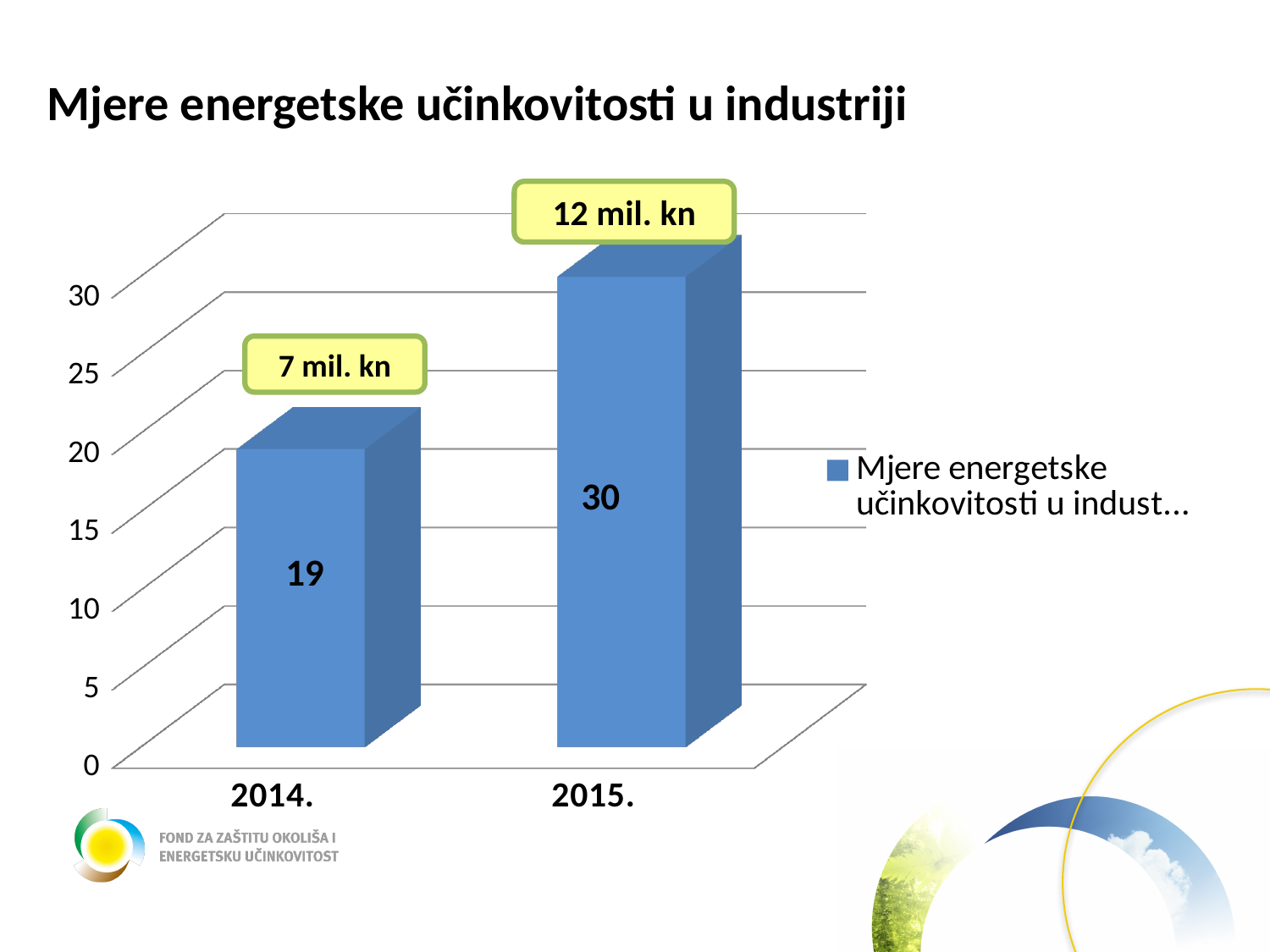
What is the value for 2014.? 19 Is the value for 2014. greater or less than 20? less How many categories are shown on the x axis? 2 Which year has the higher value? 2015. What amount is shown in the callout above the 2014. bar? 7 mil. kn Which year has the lower value? 2014. What is the difference between the values for 2015. and 2014.? 11 What is the value for 2015.? 30 What kind of chart is shown on the slide? Bar chart Do the values rise or fall from 2014. to 2015.? Rise What amount is shown in the callout above the 2015. bar? 12 mil. kn Is the value for 2015. larger than the value for 2014.? Yes